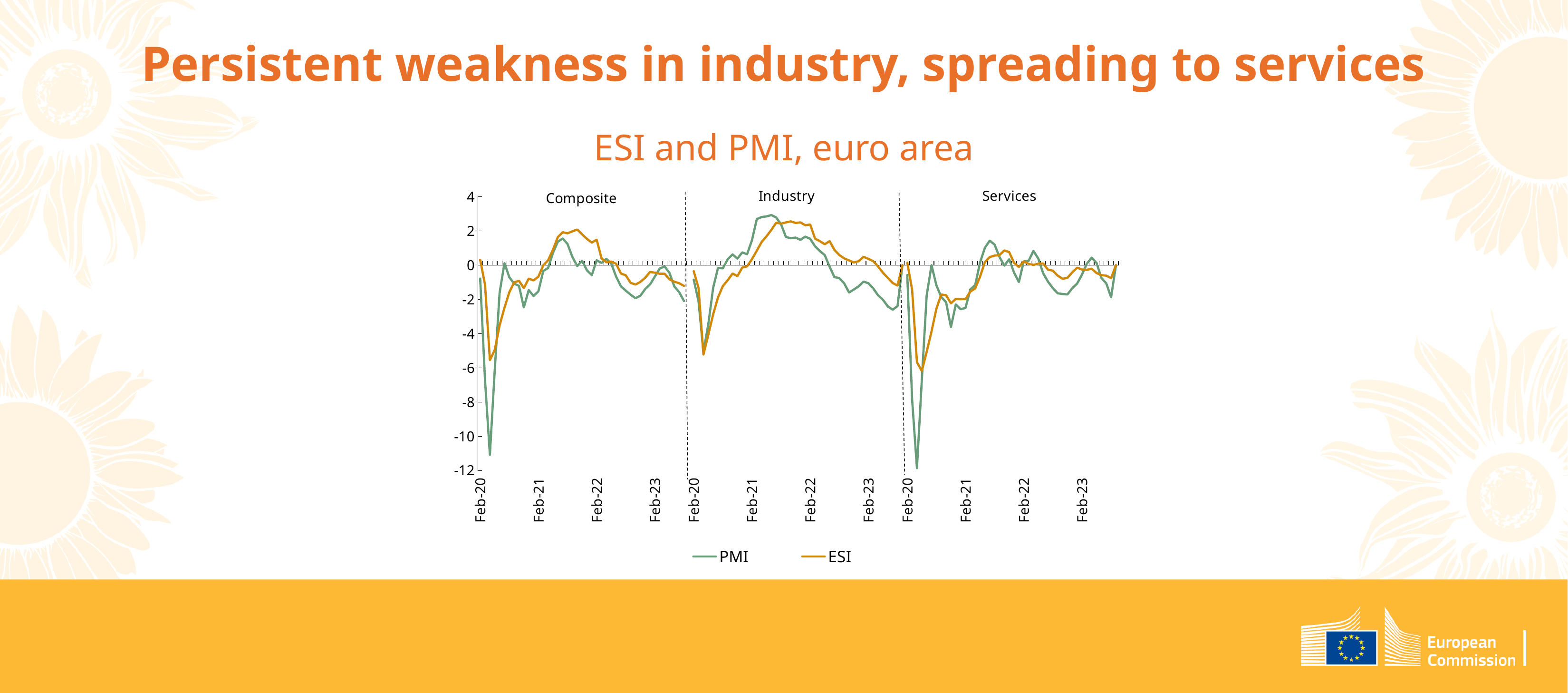
In the Composite panel, is the lowest value of the ESI line in 2020 greater or less than -4? less In the Composite panel, is the lowest value of the PMI line in 2020 greater or less than -10? less In the Industry panel, which series reaches a higher peak in 2021, PMI or ESI? PMI In the Services panel, is the lowest value of the PMI line in 2020 greater or less than -10? less How many panels (sectors) does the chart show? 3 How many series does the legend list? 2 What kind of chart is shown on the slide? line chart In the Composite panel, which series reaches a lower minimum in 2020, PMI or ESI? PMI Which colour represents the ESI series in the chart? orange In the Industry panel, do the ESI values rise or fall between Feb-22 and Feb-23? fall What is the title of the chart? ESI and PMI, euro area